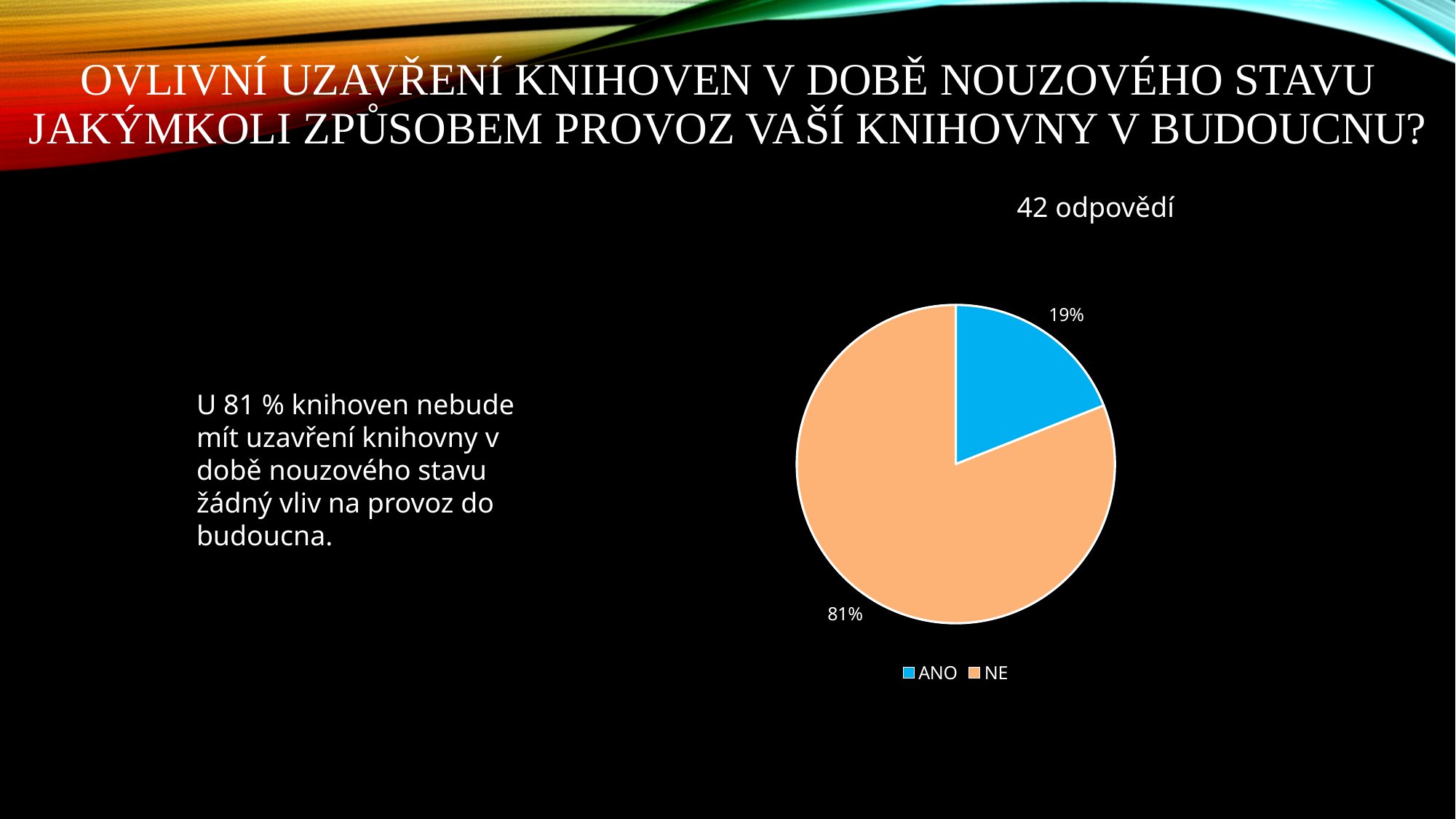
What colour is the ANO slice? blue How many entries does the legend list? 2 Is the share for NE greater or less than 50%? greater What share of the pie does NE represent? 81% Which category has the largest slice of the pie? NE How many categories does the pie chart show? 2 What is the difference in percentage points between the NE and ANO slices? 62 Which slice is larger, ANO or NE? NE How many responses does the chart's label say it is based on? 42 What kind of chart is shown on the slide? pie chart Which category has the smallest slice of the pie? ANO What share of the pie does ANO represent? 19%